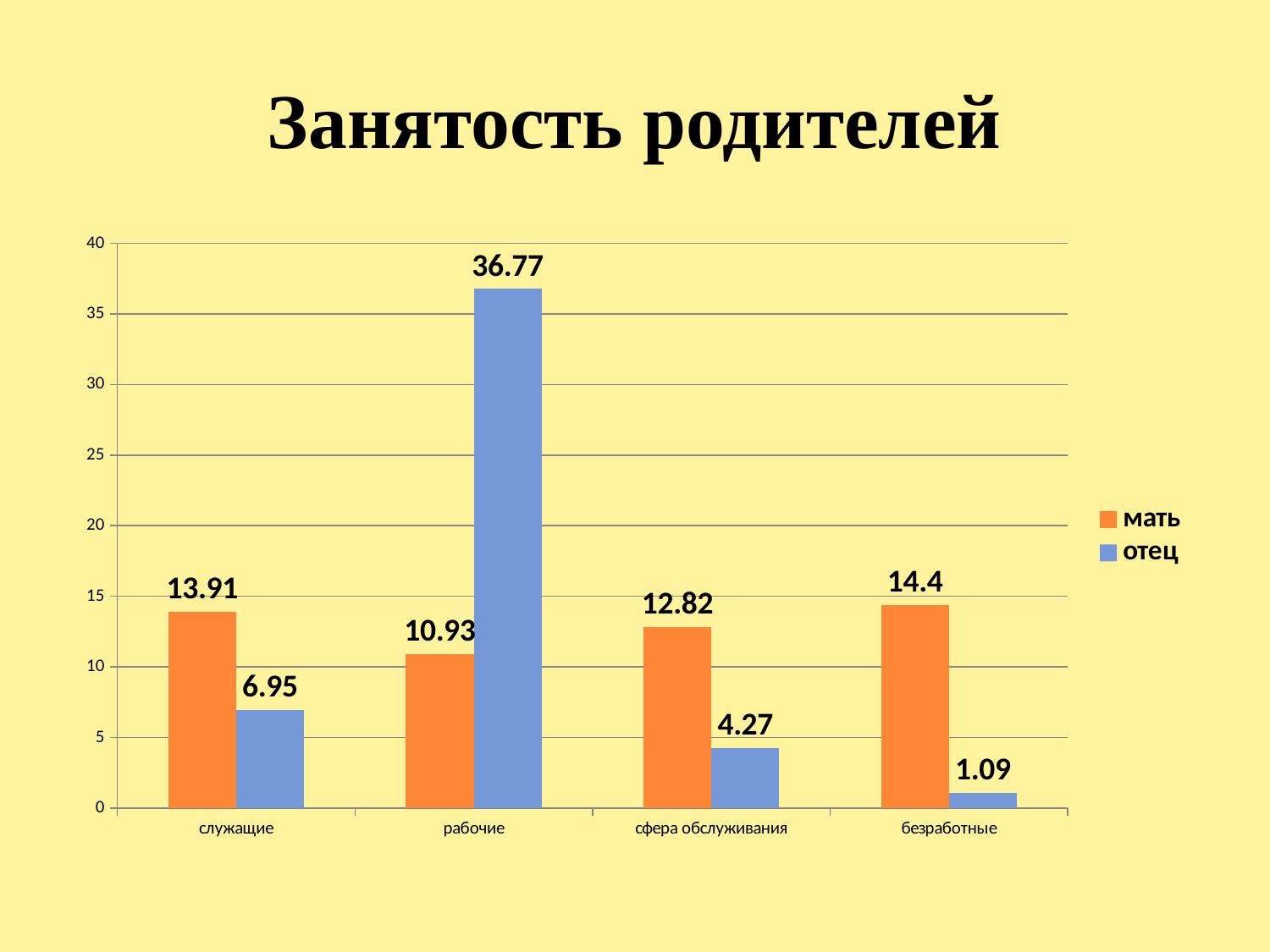
Which is larger in the рабочие category, мать or отец? отец Which category has the lowest value for мать? рабочие What is the value for отец in the безработные category? 1.09 Which category has the highest value for отец? рабочие How many categories are shown on the x axis? 4 What is the value for отец in the рабочие category? 36.77 What kind of chart is shown on the slide? bar chart What is the difference between мать and отец in the сфера обслуживания category? 8.55 What is the title of the slide? Занятость родителей How many series does the legend list? 2 Which category has the lowest value for отец? безработные What is the value for мать in the служащие category? 13.91